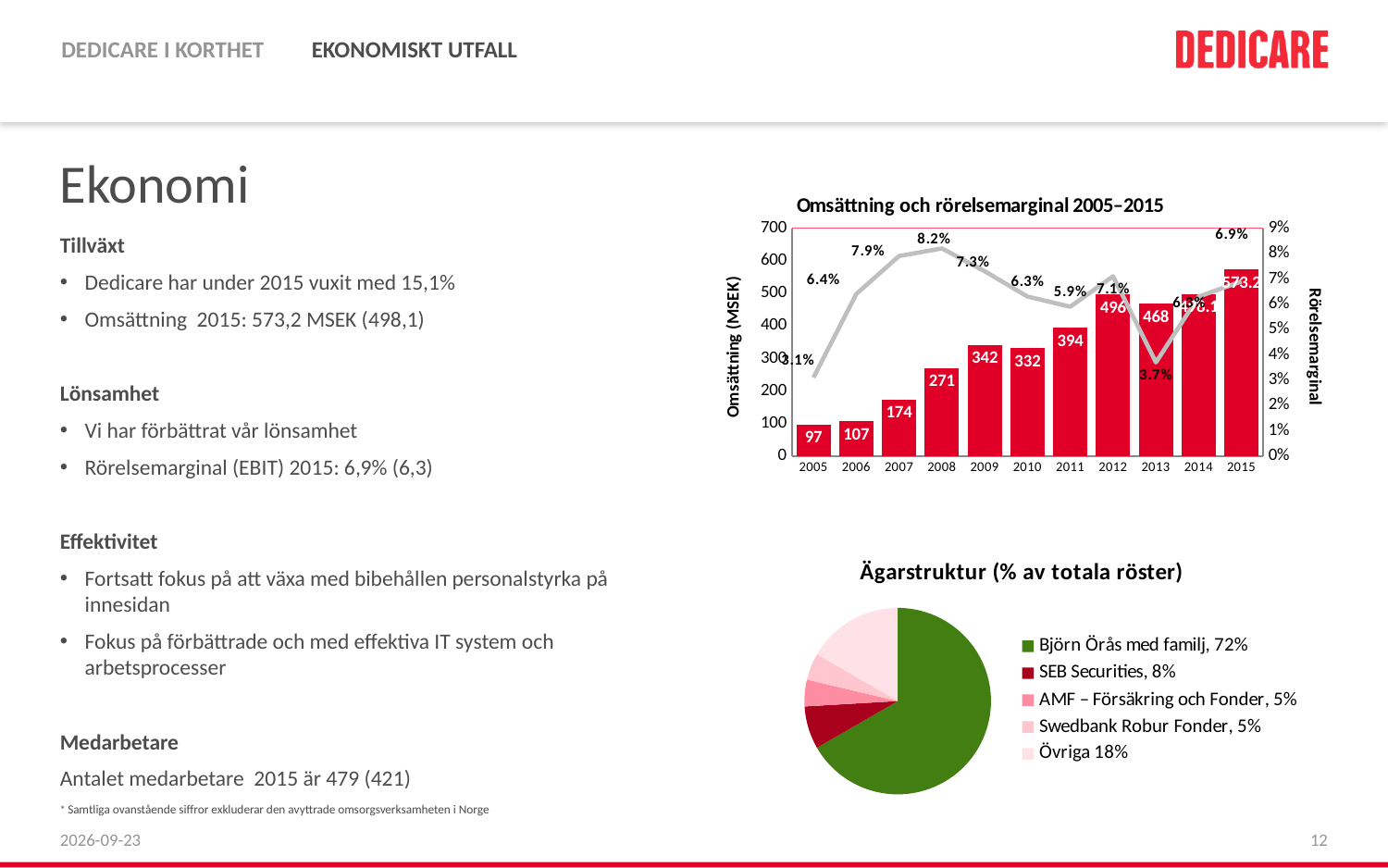
In the chart 'Omsättning och rörelsemarginal 2005–2015', which year has the highest rörelsemarginal? 2008 In the chart 'Omsättning och rörelsemarginal 2005–2015', what is the Omsättning value for 2015? 573.2 In the chart 'Omsättning och rörelsemarginal 2005–2015', what is the difference in Omsättning between 2012 and 2013? 28 In the chart 'Omsättning och rörelsemarginal 2005–2015', what is the rörelsemarginal for 2013? 3.7% In the chart 'Omsättning och rörelsemarginal 2005–2015', is the Omsättning for 2009 or 2010 larger? 2009 In the pie chart 'Ägarstruktur (% av totala röster)', what share does Björn Örås med familj hold? 72% In the chart 'Omsättning och rörelsemarginal 2005–2015', how many years are shown on the x axis? 11 In the pie chart 'Ägarstruktur (% av totala röster)', how many entries does the legend list? 5 In the pie chart 'Ägarstruktur (% av totala röster)', what is the combined share of SEB Securities and Övriga? 26% In the chart 'Omsättning och rörelsemarginal 2005–2015', what is the Omsättning value for 2011? 394 In the chart 'Omsättning och rörelsemarginal 2005–2015', what is the rörelsemarginal for 2008? 8.2% In the chart 'Omsättning och rörelsemarginal 2005–2015', which year has the lowest Omsättning? 2005